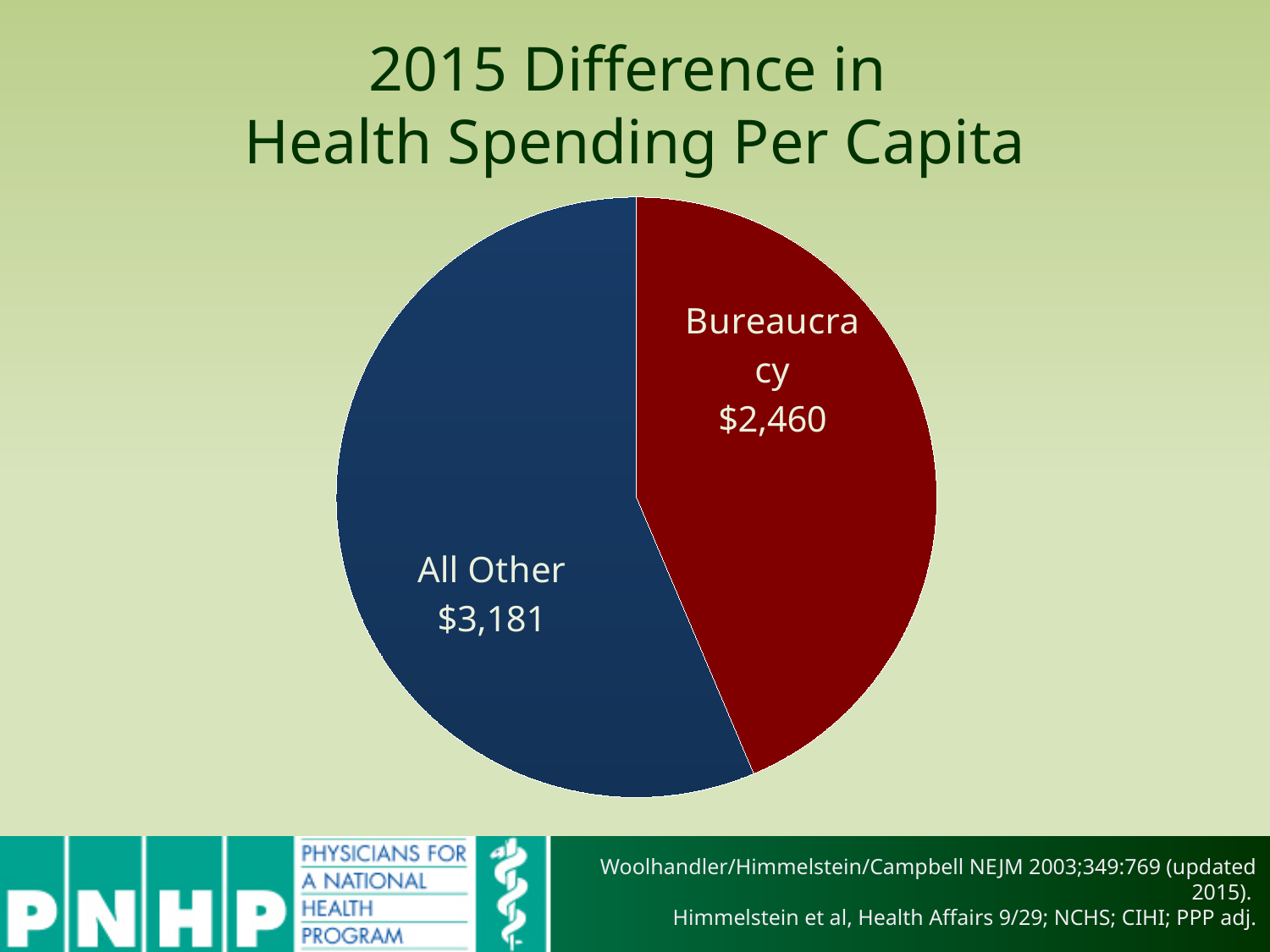
What kind of chart is shown on the slide? pie chart What is the title of the chart? 2015 Difference in Health Spending Per Capita Which slice is the smallest? Bureaucracy What is the total of the two slices? $5,641 What colour is the Bureaucracy slice? dark red Which slice is the largest? All Other What is the difference between All Other and Bureaucracy? $721 What share of the pie does Bureaucracy represent? 43.6% What is the value for All Other? $3,181 What is the value for Bureaucracy? $2,460 How many slices does the pie chart have? 2 Which is larger, Bureaucracy or All Other? All Other